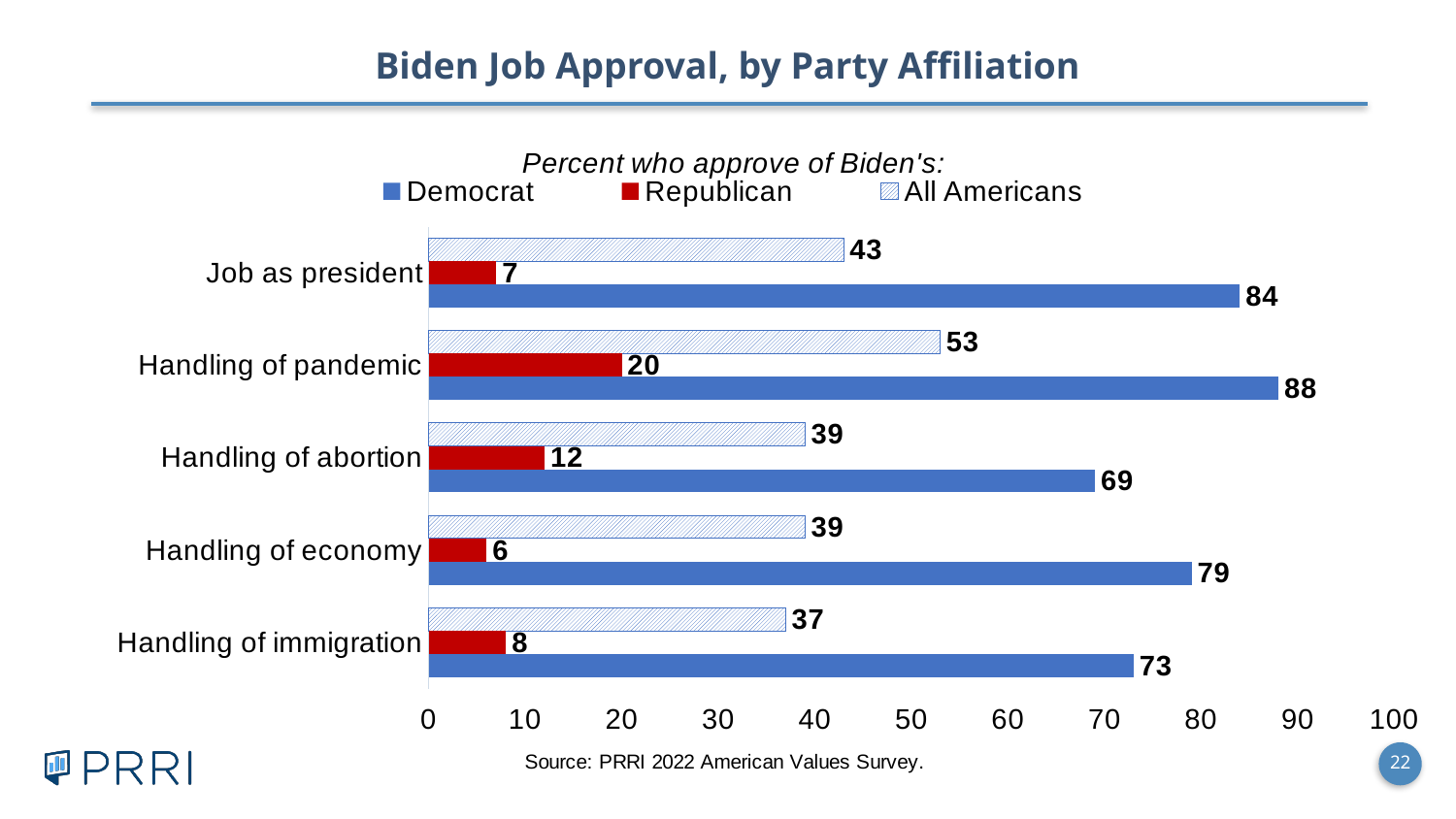
Is the Democrat value for handling of abortion greater or less than 60? greater What percent of All Americans approve of Biden's job as president? 43 Which category has the highest Democrat approval? Handling of pandemic Which category has the lowest Republican approval? Handling of economy What kind of chart is shown on the slide? Bar chart What percent of Republicans approve of Biden's handling of abortion? 12 What percent of Democrats approve of Biden's handling of the pandemic? 88 How many series does the legend list? 3 What is the difference between Democrat and Republican approval of Biden's job as president? 77 How many categories are shown on the chart? 5 What is the title of the chart? Biden Job Approval, by Party Affiliation Which is larger: All Americans' approval of handling of pandemic or of handling of immigration? Handling of pandemic